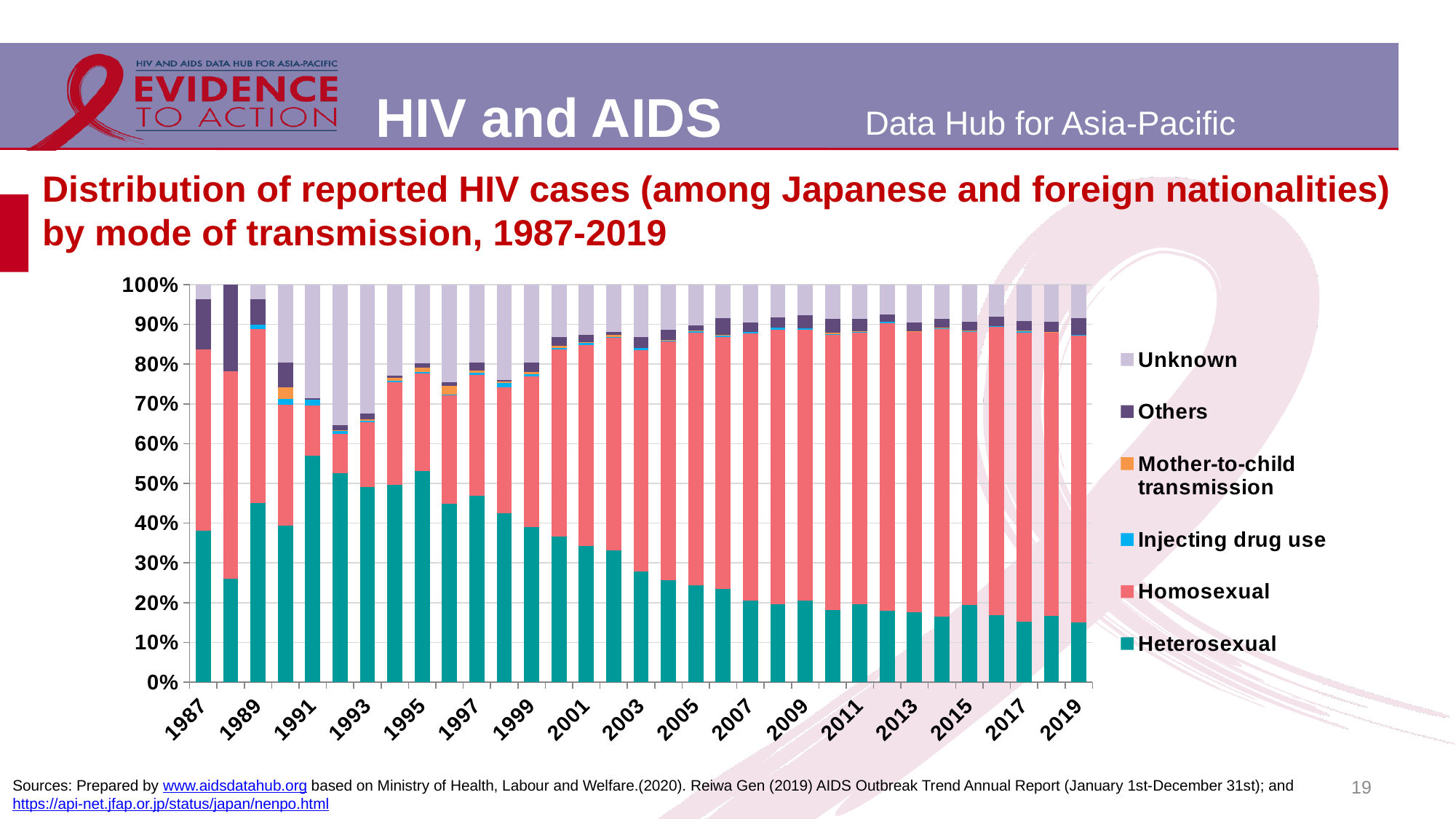
What does each stacked bar total? 100% Which year has the larger Heterosexual share, 1987 or 1988? 1987 Is the Unknown share in 1992 greater or less than 30%? greater How many years (bars) are plotted in the chart? 33 Is the Heterosexual share in 1987 greater or less than 40%? less Is the Heterosexual share in 2019 greater or less than 20%? less Does the Heterosexual share generally rise or fall from 1991 to 2019? Fall In which year is the Heterosexual share the highest? 1991 Which series is shown at the bottom of each stacked bar? Heterosexual What kind of chart is shown on the slide? Stacked bar chart How many series does the legend list? 6